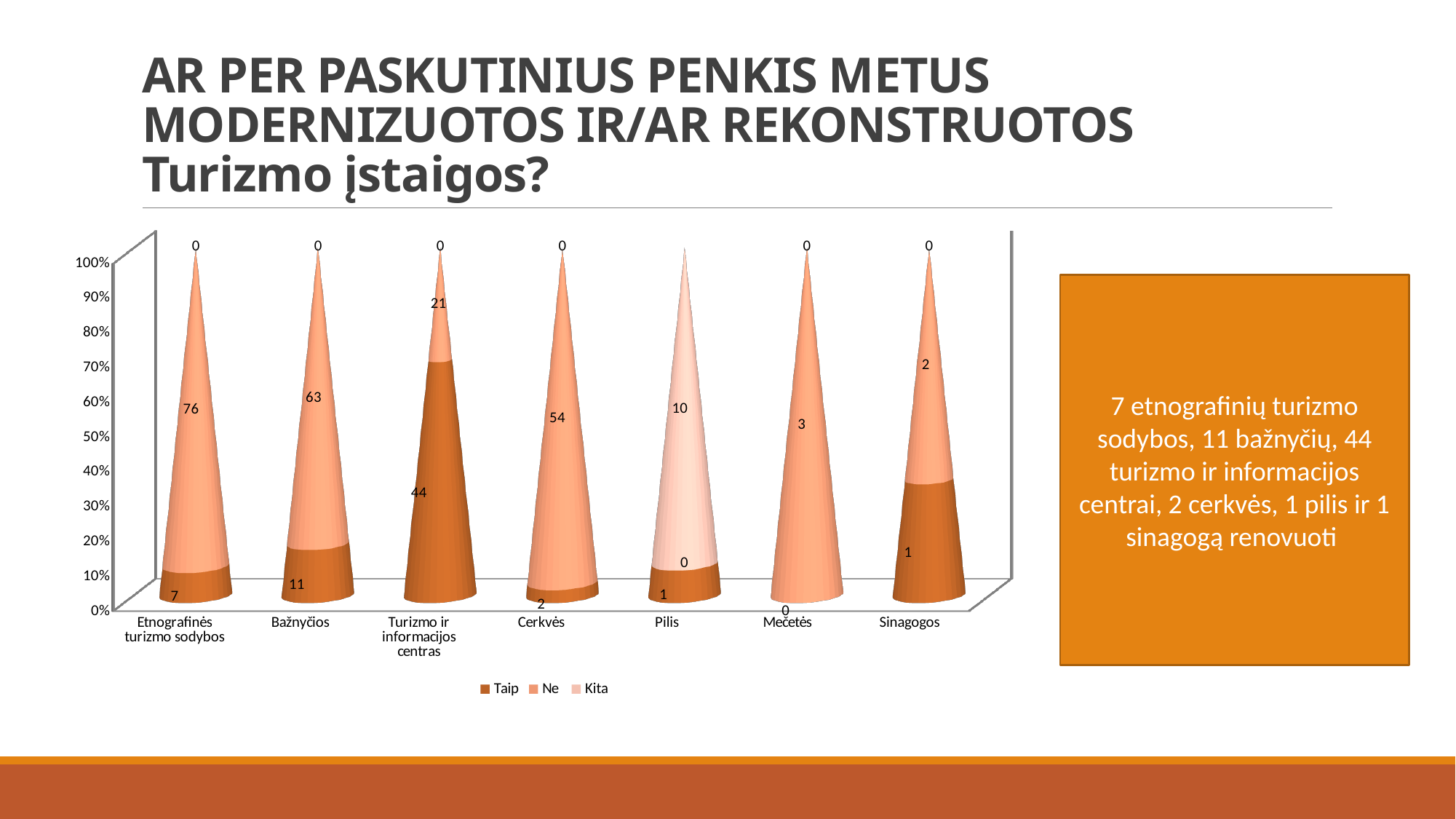
What is the Ne value for Bažnyčios? 63 What is the Taip value for Turizmo ir informacijos centras? 44 What is the Kita value for Pilis? 10 What is the difference between the Ne values for Bažnyčios and Cerkvės? 9 Which is larger, the Taip value for Bažnyčios or the Taip value for Etnografinės turizmo sodybos? Bažnyčios How many categories are shown on the x axis? 7 How many series does the legend list? 3 What kind of chart is shown on the slide? Stacked bar chart What is the Ne value for Etnografinės turizmo sodybos? 76 What are the three legend entries of the chart? Taip, Ne, Kita Which category has the highest Ne value? Etnografinės turizmo sodybos Which category has the highest Taip value? Turizmo ir informacijos centras